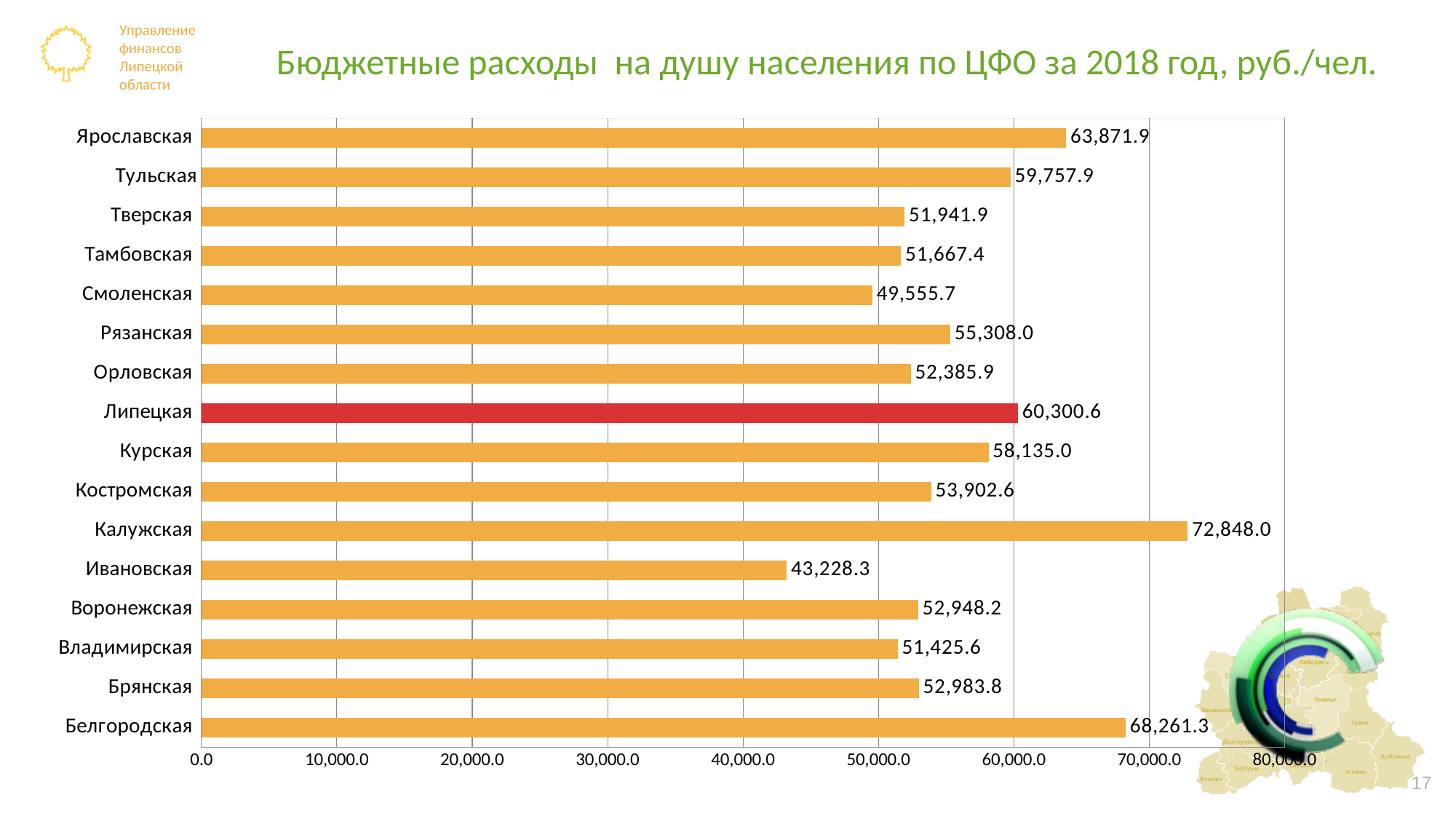
Is the value for Ивановская greater or less than 50,000.0? less Which region has the highest value? Калужская How many regions are shown in the chart? 16 Which region has the lowest value? Ивановская What is the value for Липецкая? 60,300.6 What is the difference between the values for Белгородская and Ярославская? 4,389.4 Which has a larger value, Курская or Рязанская? Курская Which region's bar is coloured red instead of orange? Липецкая What kind of chart is shown on the slide? bar chart What is the value for Смоленская? 49,555.7 What is the value for Калужская? 72,848.0 What is the difference between the values for Калужская and Липецкая? 12,547.4